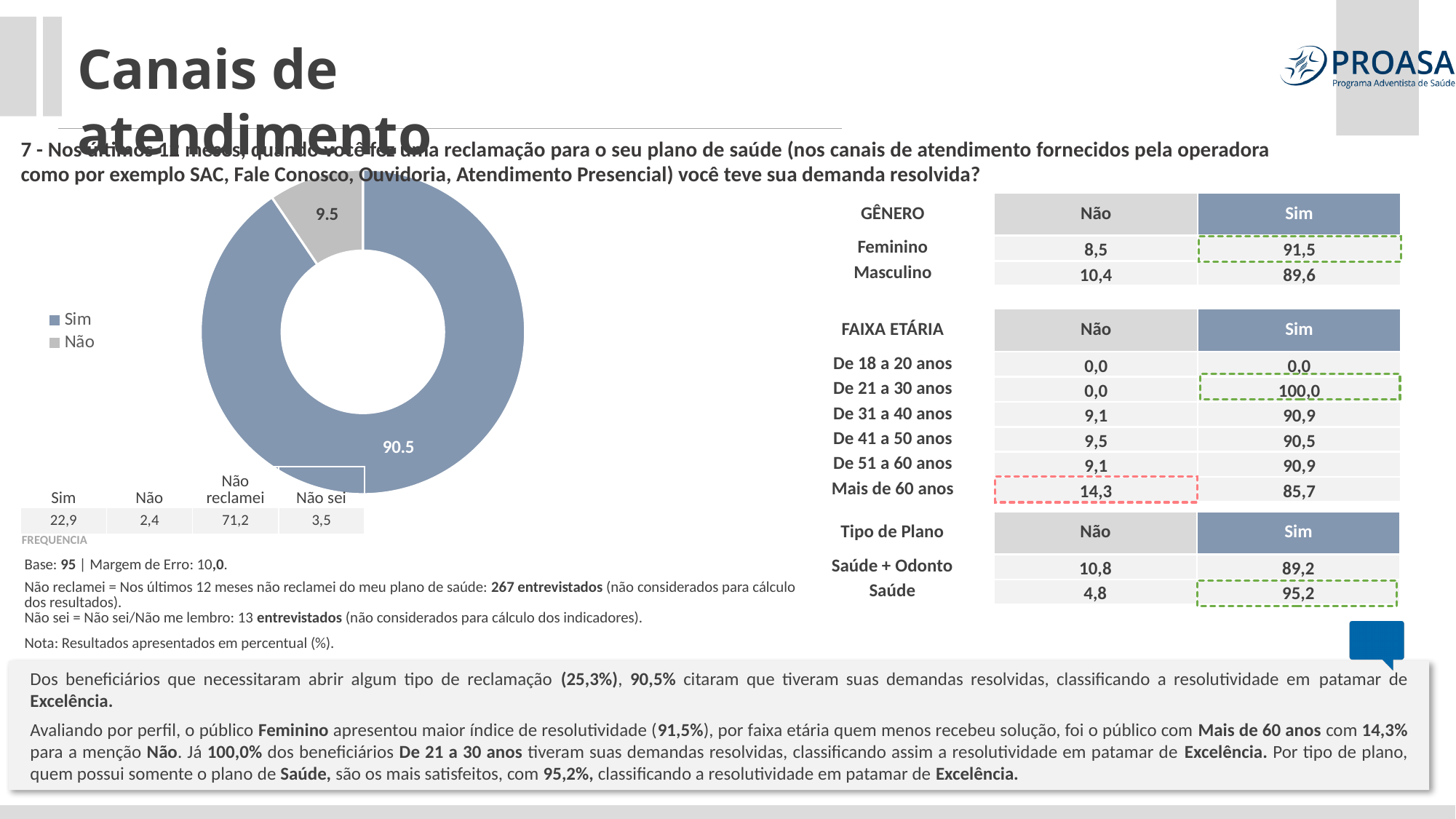
What kind of chart is shown on the slide? doughnut chart What is the value shown for the Não slice in the pie chart? 9.5 How many entries does the pie chart's legend list? 2 What colour is the Sim slice in the pie chart? blue Which slice of the pie chart is the largest? Sim What share of the pie chart does the Sim slice represent? 90.5 How many slices does the pie chart have? 2 In the pie chart, which is larger, Sim or Não? Sim What is the value shown for the Sim slice in the pie chart? 90.5 What is the difference between the Sim and Não values in the pie chart? 81 What colour is the Não slice in the pie chart? grey Which slice of the pie chart is the smallest? Não